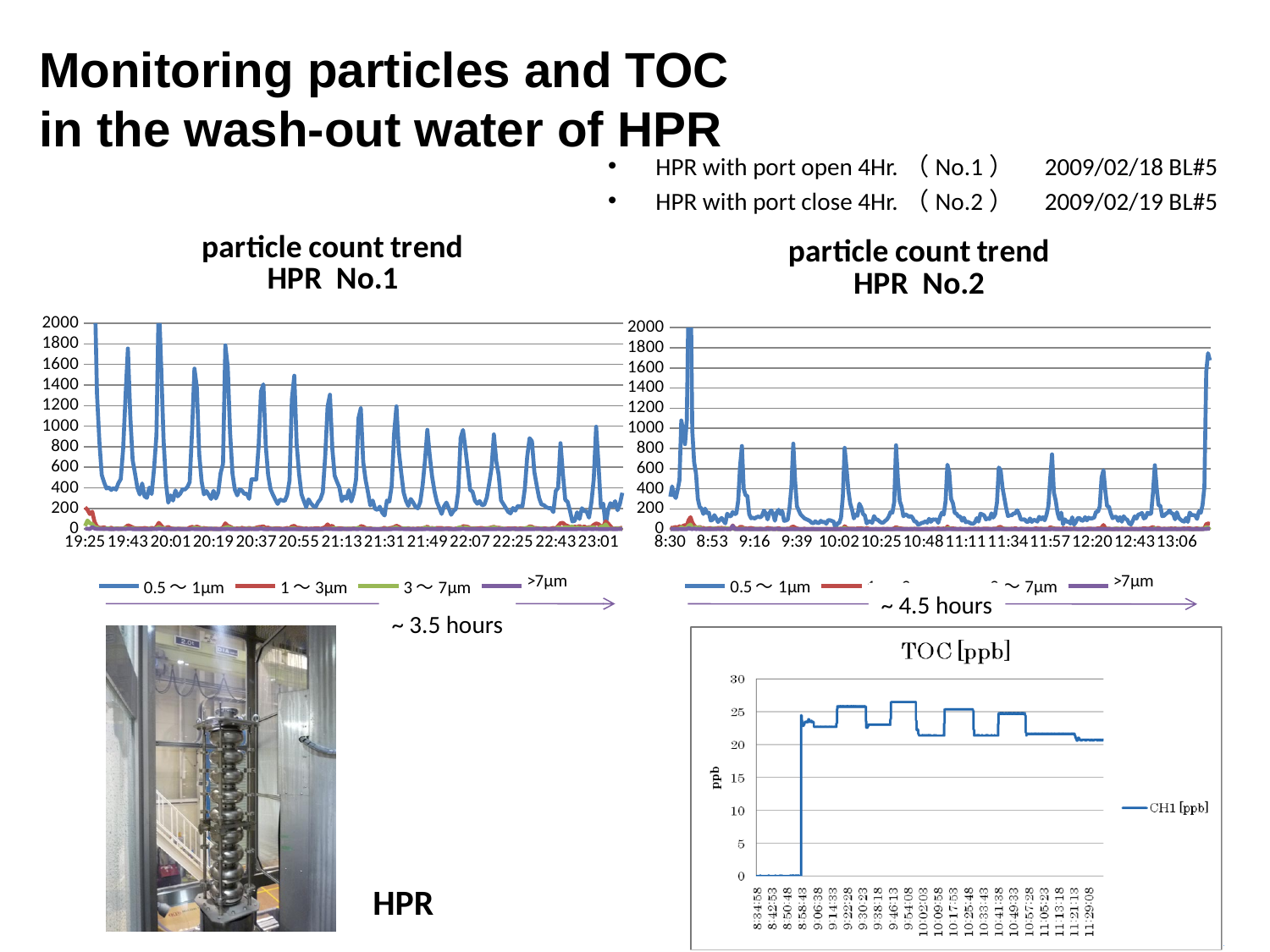
In the 'TOC [ppb]' chart, is the value at 8:34:58 greater or less than 5? less In the 'particle count trend HPR No.1' chart, is the 0.5～1μm peak near 19:43 greater or less than 1600? greater In the 'particle count trend HPR No.2' chart, which 0.5～1μm peak is larger, the one near 8:30 or the one near 9:39? the one near 8:30 In the 'TOC [ppb]' chart, is the value at 9:22:28 greater or less than 20? greater How many series does the legend of the 'particle count trend HPR No.1' chart list? 4 What kind of chart is the 'particle count trend HPR No.1' chart? line chart In the 'particle count trend HPR No.1' chart, which series has the highest values? 0.5～1μm How many series does the legend of the 'TOC [ppb]' chart list? 1 In the 'particle count trend HPR No.1' chart, do the heights of the 0.5～1μm peaks rise or fall over time along the x axis? fall What is the legend entry of the 'TOC [ppb]' chart? CH1 [ppb] What is the maximum value shown on the y axis of the 'TOC [ppb]' chart? 30